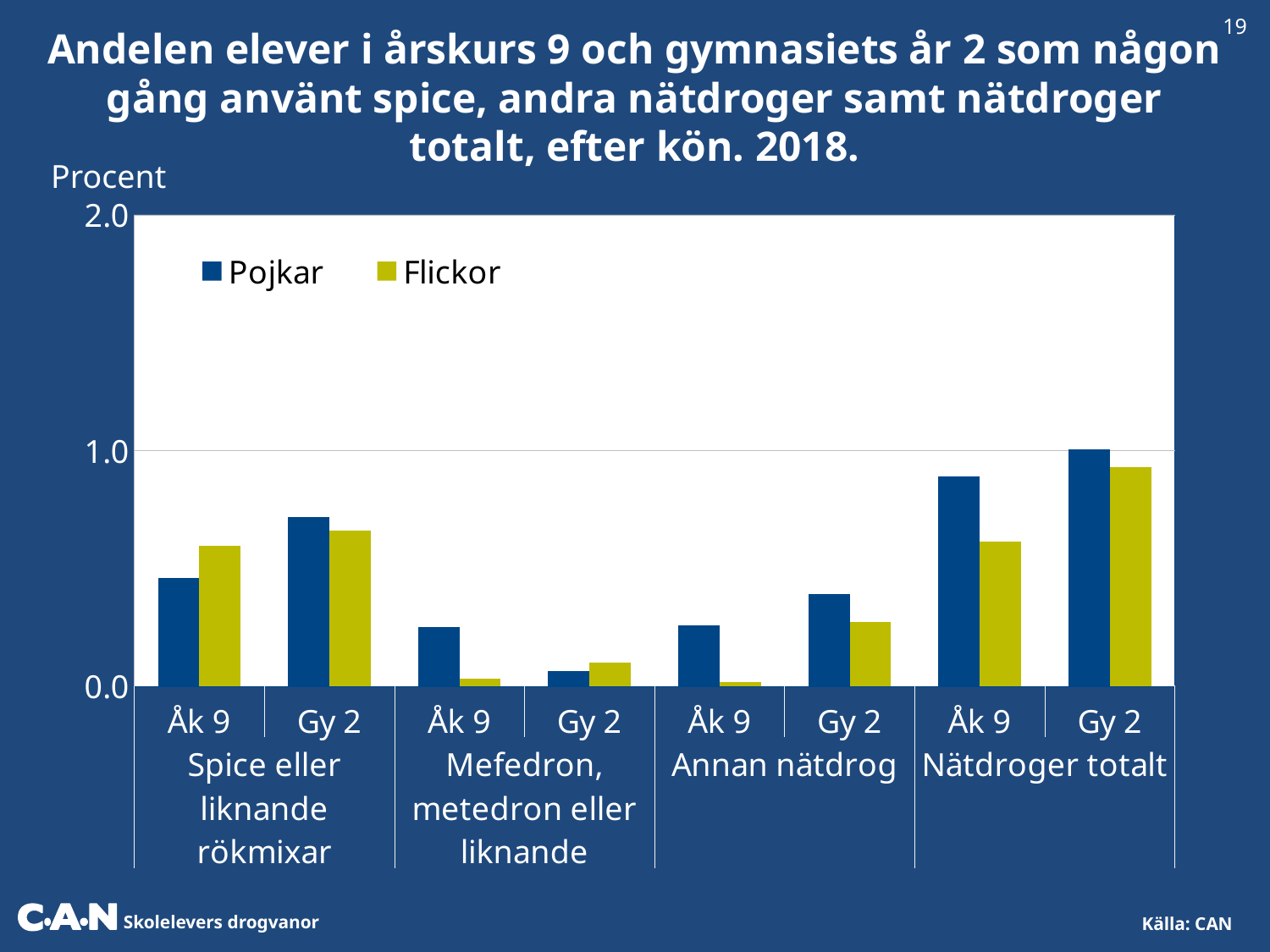
For Gy 2 in the Spice eller liknande rökmixar group, which is larger, Pojkar or Flickor? Pojkar Is the value for Pojkar, Åk 9, Nätdroger totalt greater or less than 1.0? less What kind of chart is shown on the slide? bar chart Is the value for Flickor, Gy 2, Nätdroger totalt greater or less than 1.0? less For Åk 9 in the Nätdroger totalt group, which is larger, Pojkar or Flickor? Pojkar For Åk 9 in the Mefedron, metedron eller liknande group, which is larger, Pojkar or Flickor? Pojkar What are the two series named in the legend? Pojkar and Flickor How many series does the legend list? 2 Which bar is the highest in the chart? Pojkar, Gy 2, Nätdroger totalt How many drug categories are shown along the x axis? 4 What label is shown on the vertical axis? Procent